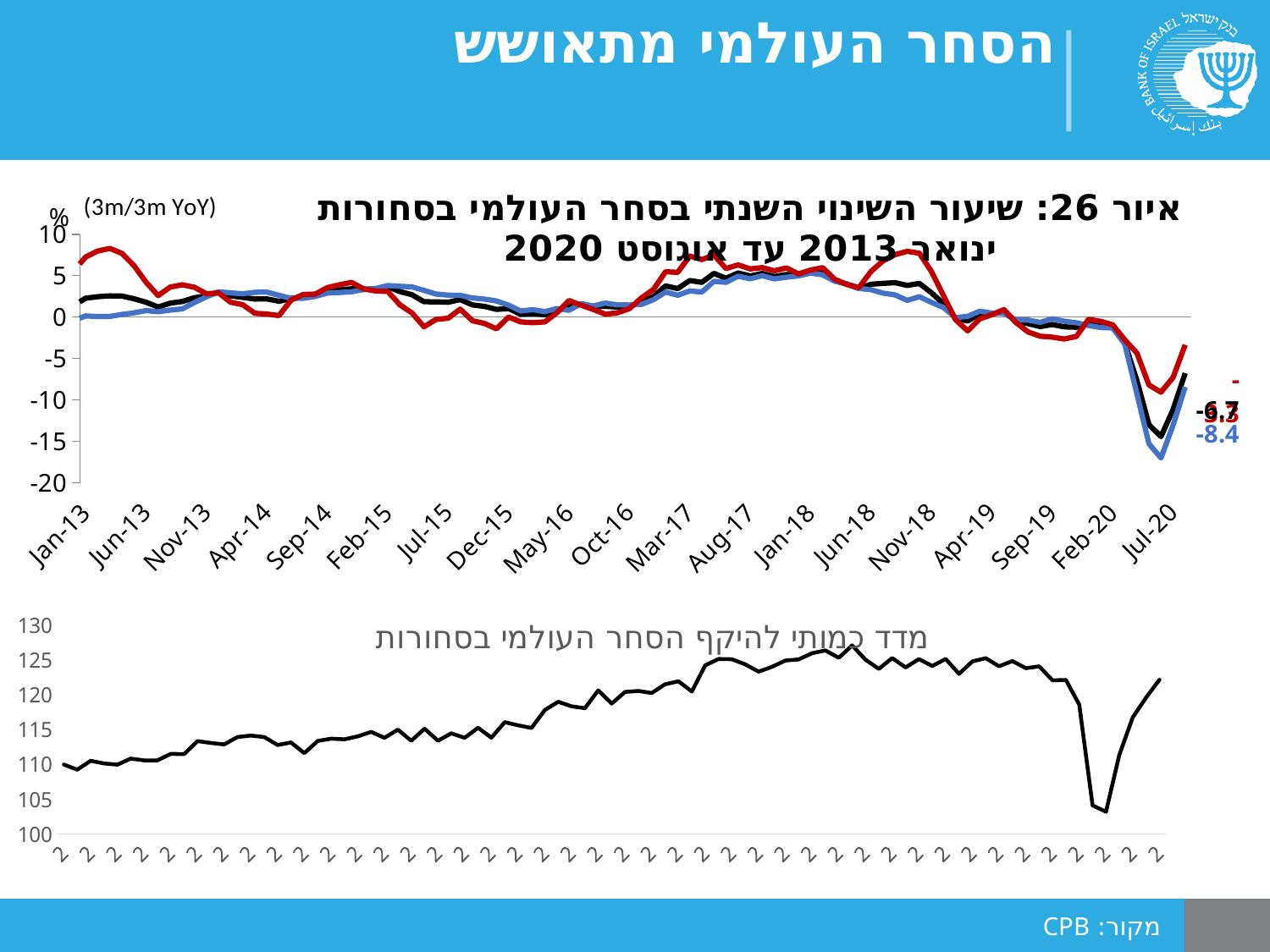
In the bottom chart, is the highest point of the line greater or less than 120? greater In the bottom chart, is the lowest point of the line greater or less than 105? less In the top chart (איור 26), what is the final value labelled on the blue line? -8.4 What unit note is shown next to the y axis of the top chart (איור 26)? (3m/3m YoY) In the top chart (איור 26), what is the final value labelled on the black line? -6.7 How many lines are plotted in the top chart (איור 26)? 3 In the top chart (איור 26), what is the first label on the x axis? Jan-13 What kind of chart is the top chart (איור 26)? line chart In the bottom chart, is the value at the start of the series greater or less than 115? less What kind of chart is the bottom chart (מדד כמותי להיקף הסחר העולמי בסחורות)? line chart